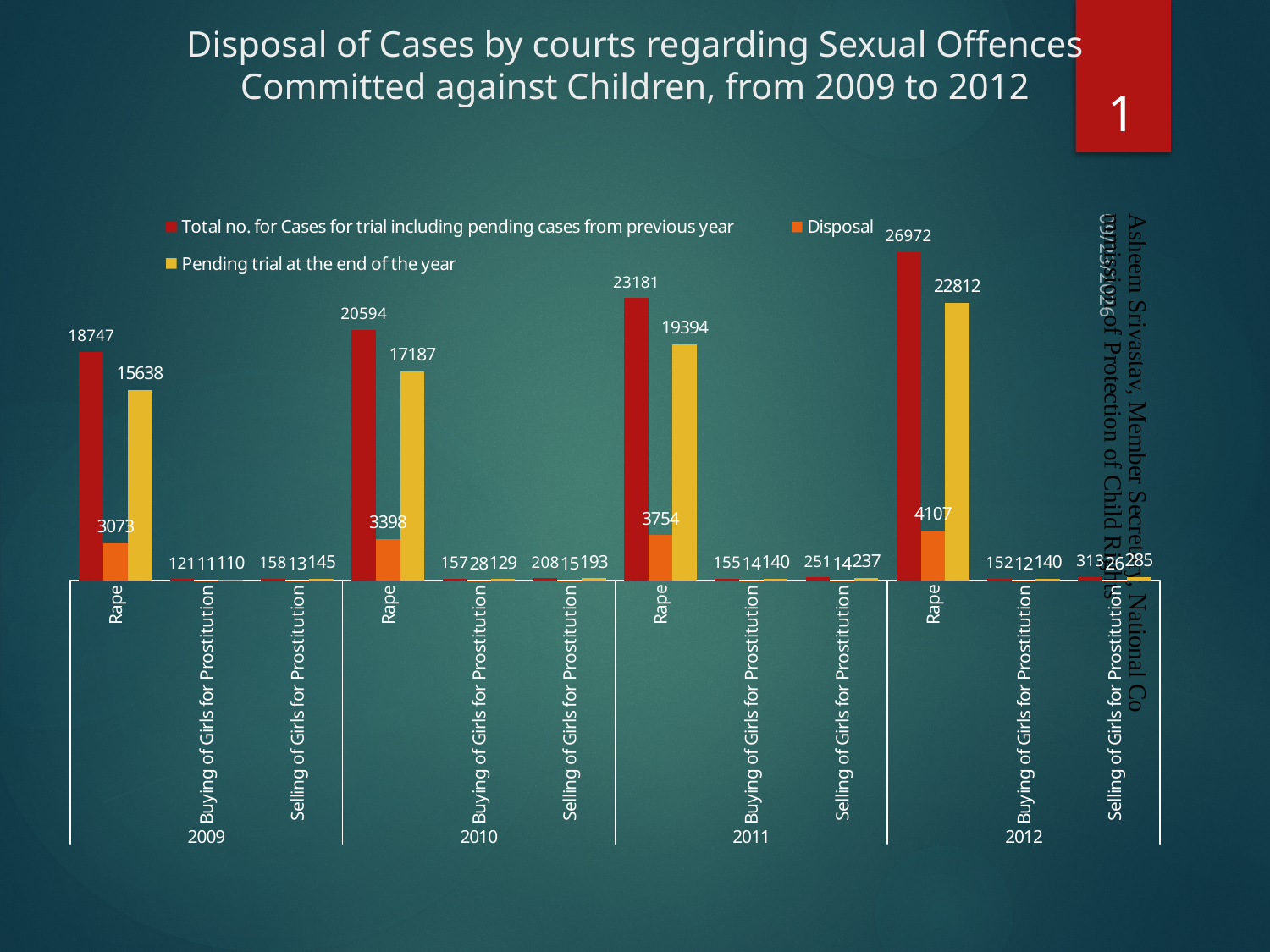
Does the total number of cases for trial for Rape rise or fall from 2009 to 2012? Rise What is the Pending trial at the end of the year value for Rape in 2011? 19394 In which year is the Disposal value for Rape the lowest? 2009 What is the Disposal value for Rape in 2009? 3073 What is the Disposal value for Buying of Girls for Prostitution in 2010? 28 Which is larger: the Pending trial value for Rape in 2010 or in 2009? 2010 What is the Pending trial at the end of the year value for Selling of Girls for Prostitution in 2012? 285 What is the difference between the total cases for trial for Rape in 2012 and in 2011? 3791 What kind of chart is shown on the slide? Bar chart What is the total number of cases for trial for Rape in 2012? 26972 In which year is the total number of cases for trial for Rape the highest? 2012 How many series does the legend list? 3